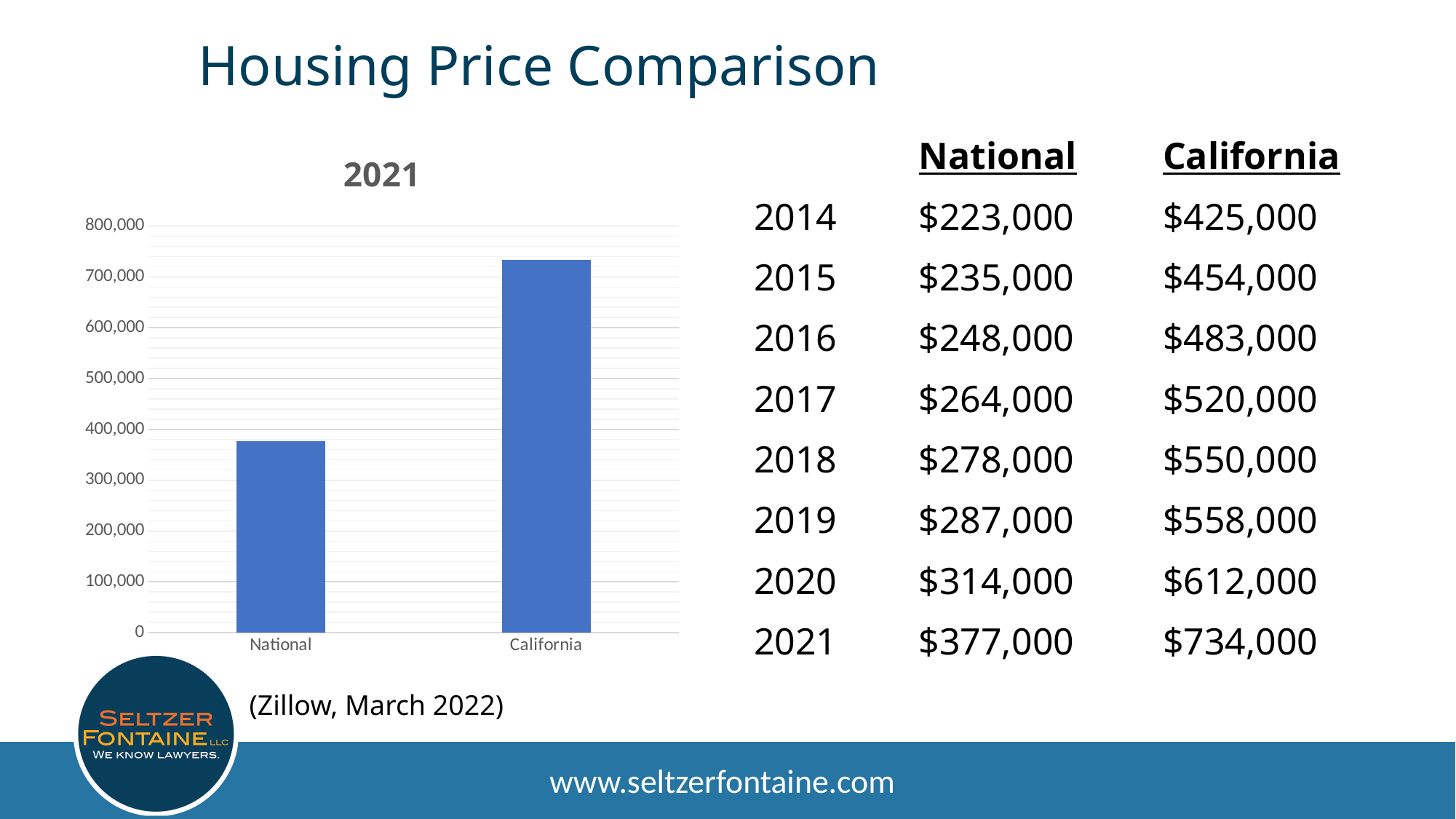
What is the difference between the 2021 California and National housing prices shown on the slide? $357,000 According to the slide, what is the 2021 National housing price plotted in the chart? $377,000 Which category has the taller bar in the chart, National or California? California Which category has the lowest value in the chart? National Is the value for California in the chart greater or less than 700,000? greater Which category has the highest value in the chart? California How many bars does the chart show? 2 What is the title of the chart? 2021 What kind of chart is shown on the slide? bar chart Is the value for National in the chart greater or less than 300,000? greater Is the value for National in the chart greater or less than 400,000? less According to the slide, what is the 2021 California housing price plotted in the chart? $734,000